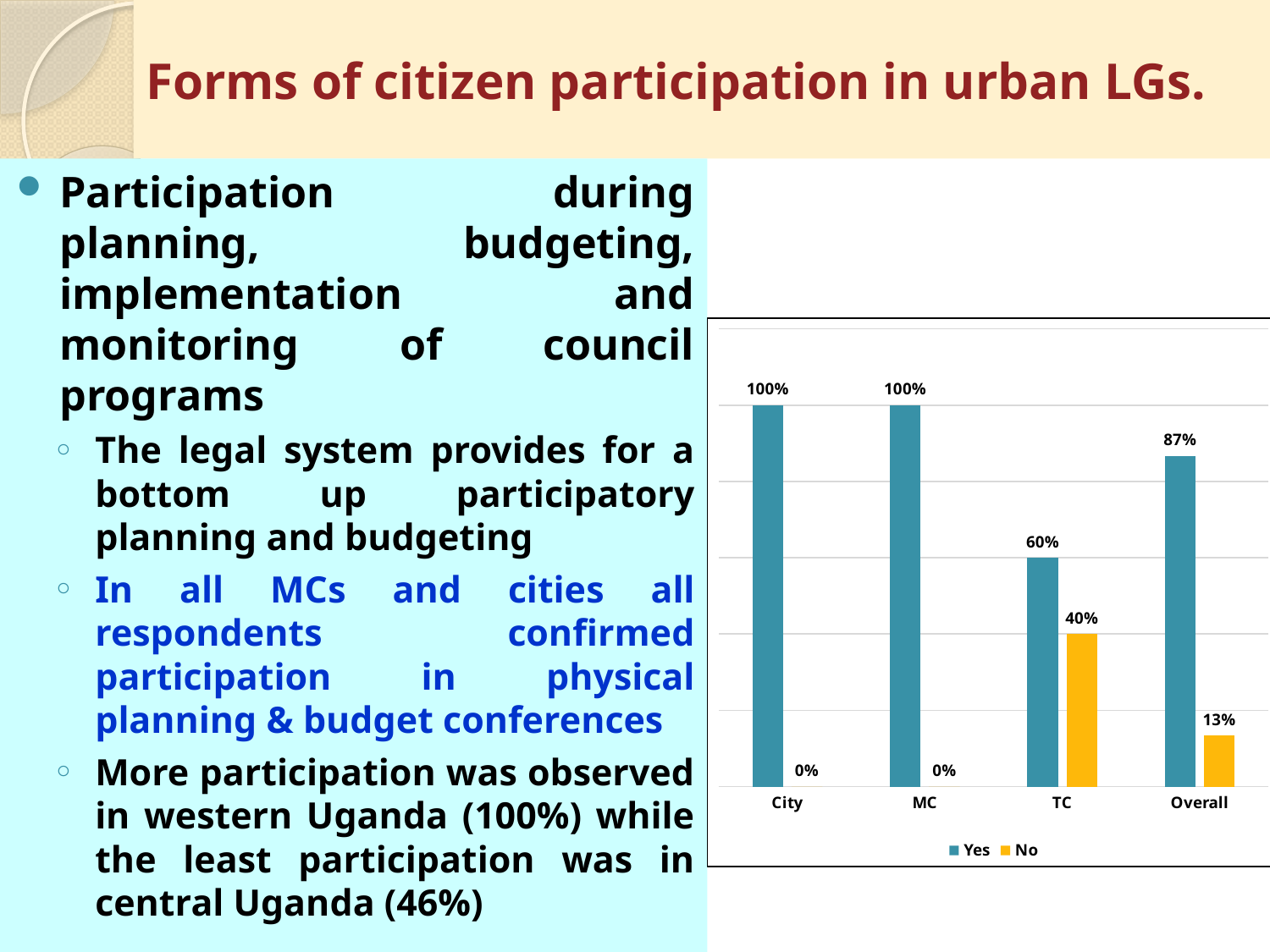
How many categories are shown on the x axis? 4 What is the 'No' value for Overall? 13% What is the 'Yes' value for TC? 60% What is the 'Yes' value for Overall? 87% Which category has the highest 'No' value? TC What is the difference between the 'Yes' value for MC and the 'Yes' value for Overall? 13% Which category has the lowest 'Yes' value? TC What kind of chart is shown on the slide? Bar chart Which is larger, the 'No' value for TC or the 'No' value for Overall? TC What is the 'No' value for TC? 40% How many series does the legend list? 2 What is the difference between the 'Yes' and 'No' values for TC? 20%